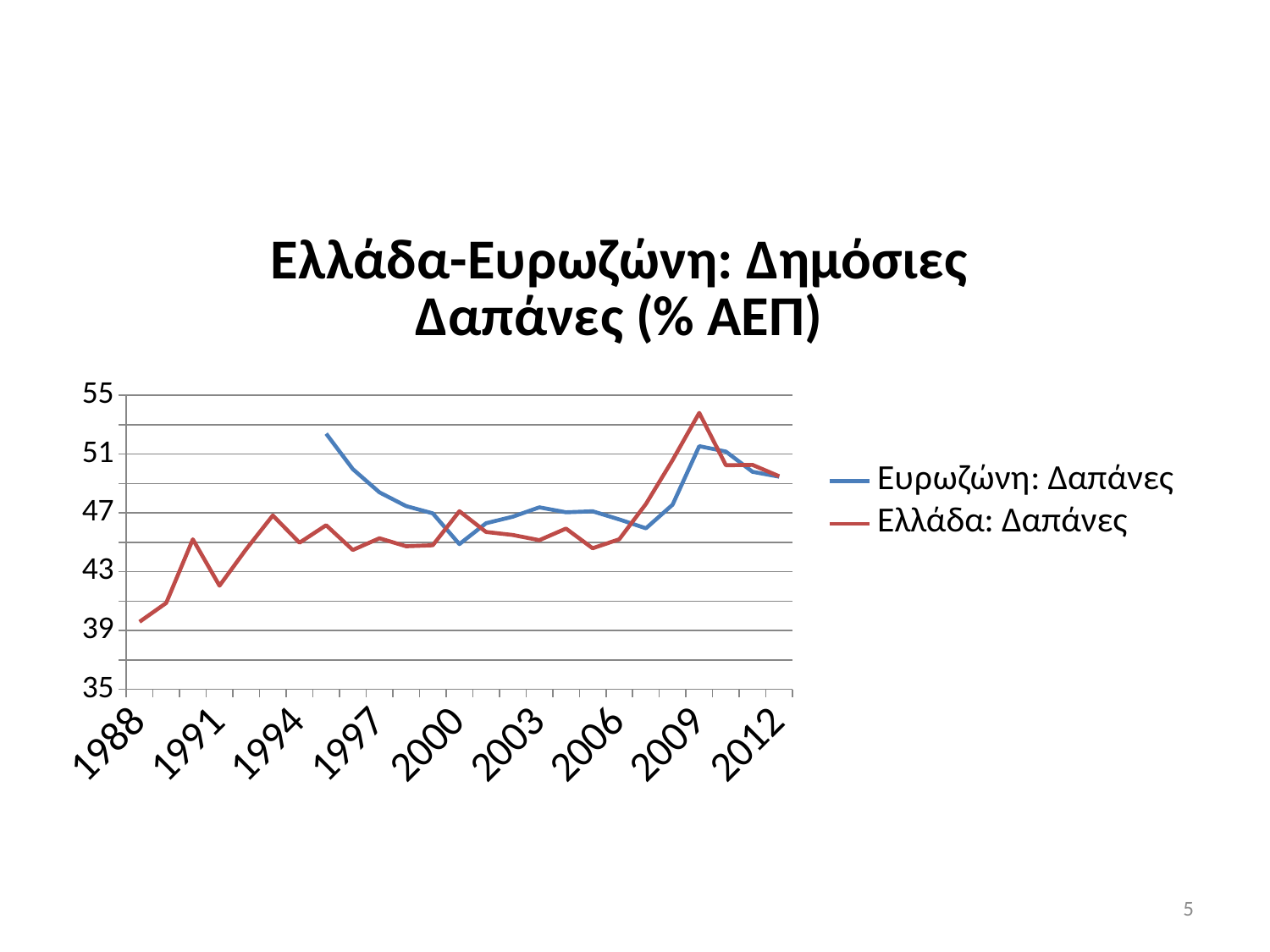
How many series does the legend list? 2 What kind of chart is shown on the slide? line chart In which year does Ελλάδα: Δαπάνες reach its highest value? 2009 In which year does Ελλάδα: Δαπάνες have its lowest value? 1988 Is the value for Ελλάδα: Δαπάνες in 2009 greater or less than 51? greater In 1996, which series has the higher value, Ελλάδα: Δαπάνες or Ευρωζώνη: Δαπάνες? Ευρωζώνη: Δαπάνες In 2009, which series has the higher value, Ελλάδα: Δαπάνες or Ευρωζώνη: Δαπάνες? Ελλάδα: Δαπάνες Is the value for Ευρωζώνη: Δαπάνες in 2012 greater or less than 51? less Is the value for Ευρωζώνη: Δαπάνες in 1996 greater or less than 51? less Which series is drawn in red? Ελλάδα: Δαπάνες What is the title of the chart? Ελλάδα-Ευρωζώνη: Δημόσιες Δαπάνες (% ΑΕΠ)